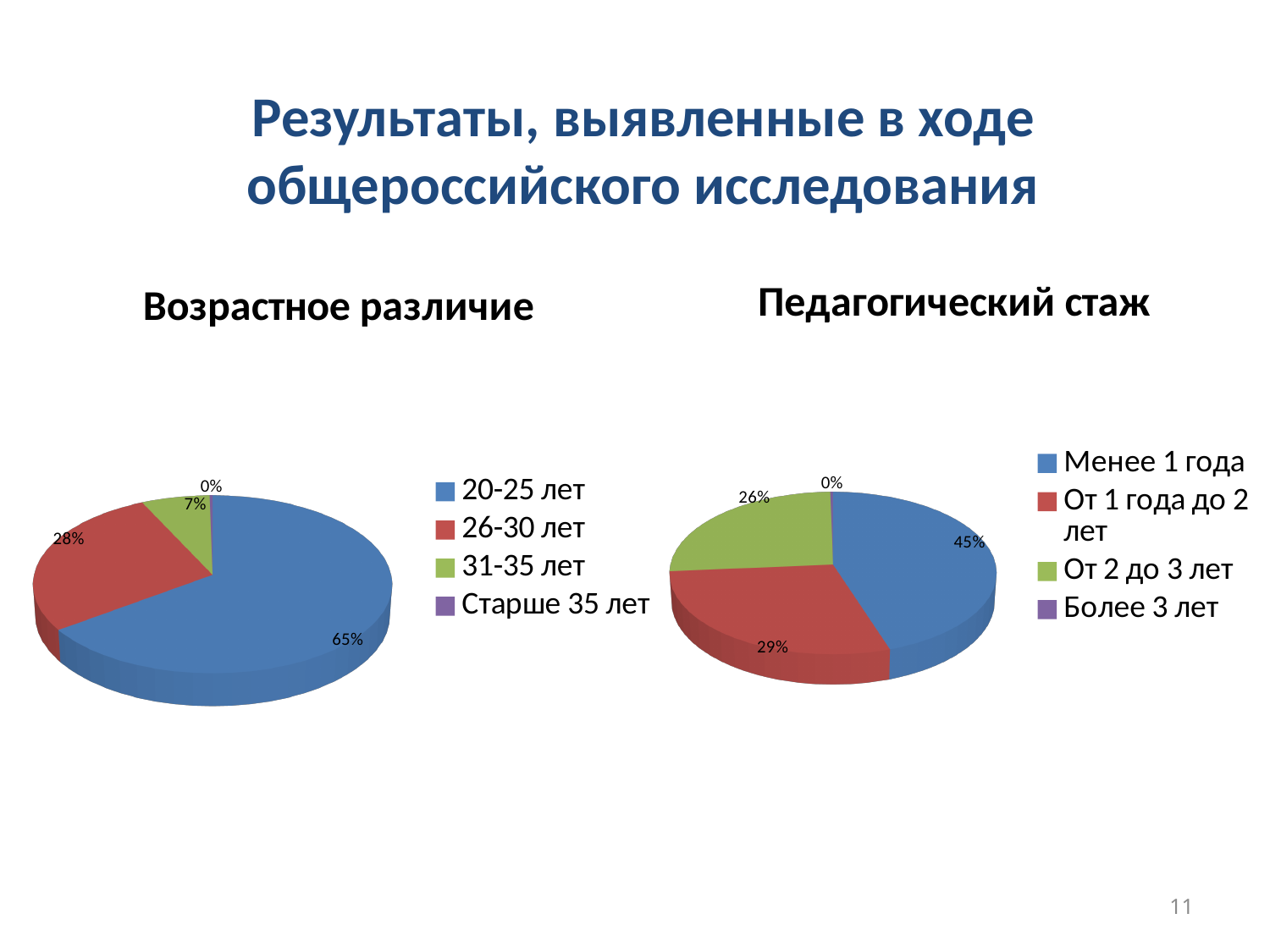
In the "Возрастное различие" chart, what share of the pie is the "20-25 лет" slice? 65% In the "Возрастное различие" chart, which category has the largest slice? 20-25 лет In the "Педагогический стаж" chart, which category has the smallest slice? Более 3 лет In the "Педагогический стаж" chart, what is the value for "От 2 до 3 лет"? 26% What type of chart is the "Педагогический стаж" chart? Pie chart How many entries does the legend of the "Возрастное различие" chart list? 4 In the "Педагогический стаж" chart, what colour is the "Менее 1 года" slice? Blue In the "Педагогический стаж" chart, what is the value for "Менее 1 года"? 45% In the "Возрастное различие" chart, what is the value for "26-30 лет"? 28% In the "Педагогический стаж" chart, which is larger: "От 1 года до 2 лет" or "От 2 до 3 лет"? От 1 года до 2 лет In the "Возрастное различие" chart, what is the difference between the "20-25 лет" and "26-30 лет" slices? 37% In the "Возрастное различие" chart, what is the value for "31-35 лет"? 7%